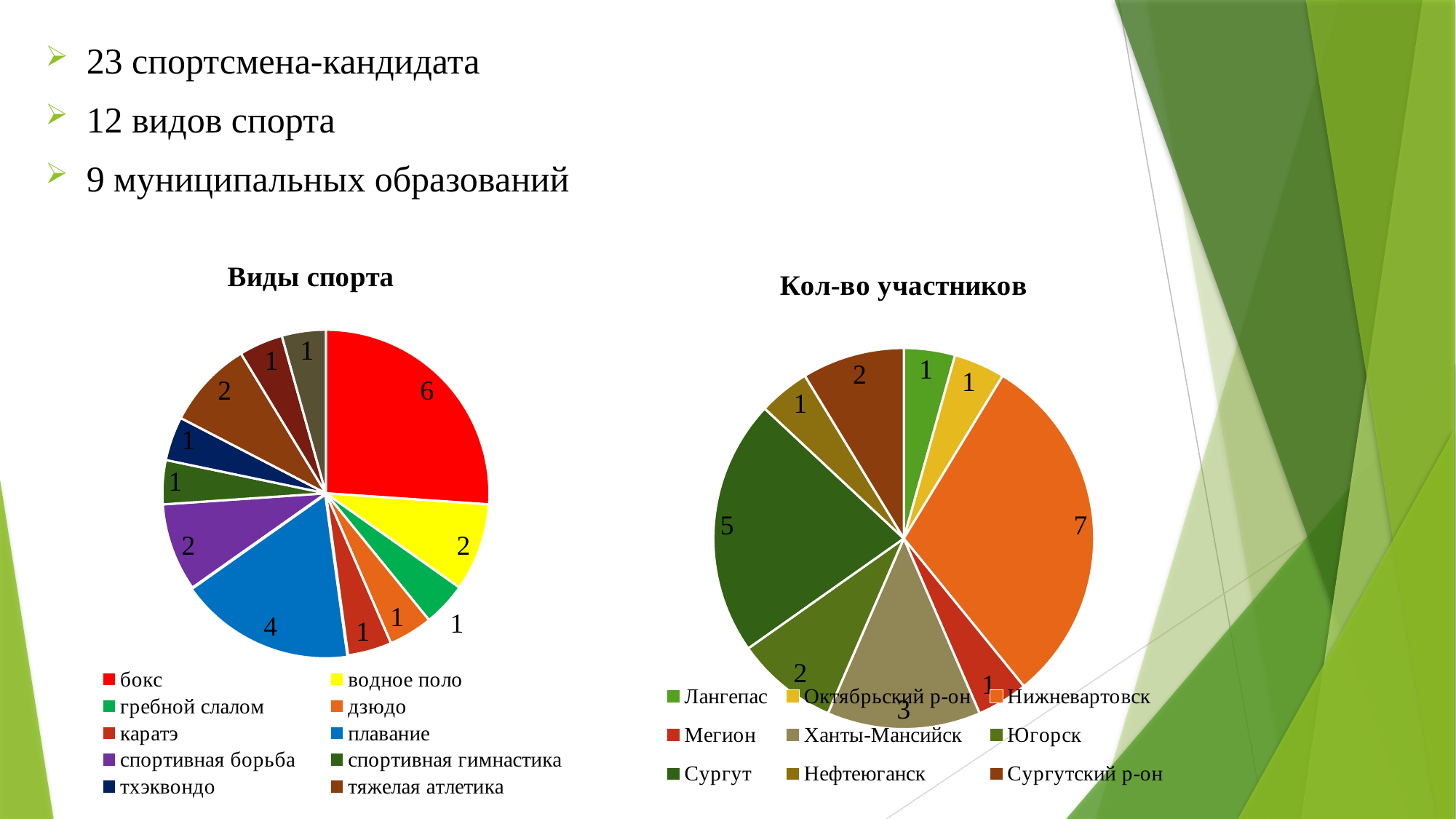
In the 'Кол-во участников' chart, what is the value for Сургут? 5 In the 'Виды спорта' chart, what is the value for плавание? 4 In the 'Кол-во участников' chart, what is the difference between the values for Нижневартовск and Сургут? 2 In the 'Кол-во участников' chart, what is the value for Ханты-Мансийск? 3 What type of chart is the 'Кол-во участников' chart? pie chart In the 'Виды спорта' chart, what is the difference between the values for бокс and плавание? 2 In the 'Кол-во участников' chart, which is larger: Ханты-Мансийск or Югорск? Ханты-Мансийск In the 'Кол-во участников' chart, what is the value for Нижневартовск? 7 In the 'Кол-во участников' chart, which municipality has the largest slice? Нижневартовск In the 'Виды спорта' chart, which sport has the largest slice? бокс In the 'Виды спорта' chart, what is the value for бокс? 6 In the 'Виды спорта' chart, how many slices does the pie have? 12